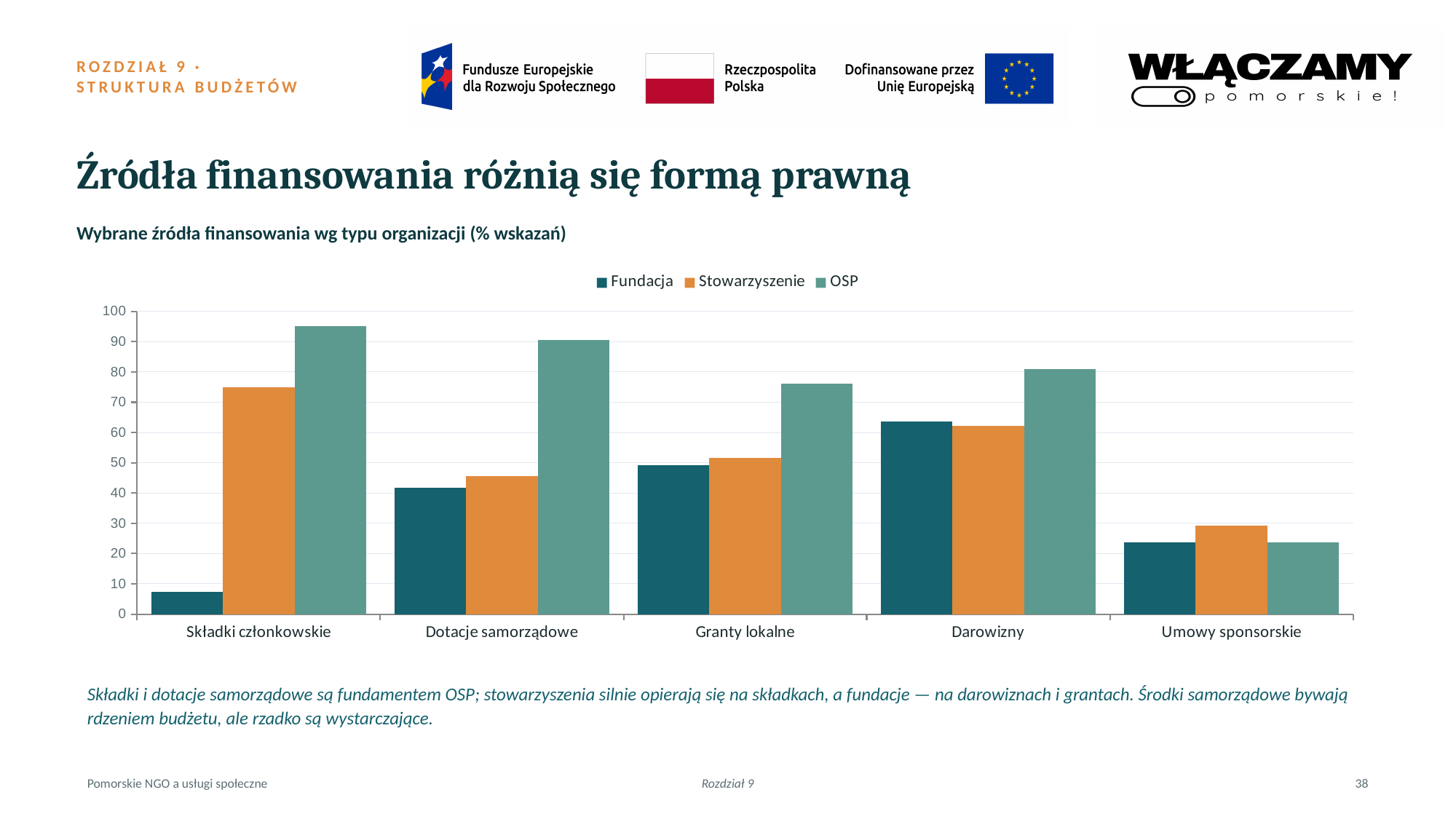
Is the value for OSP in Dotacje samorządowe greater or less than 80? greater Which series has the lowest value for Składki członkowskie? Fundacja Which is larger for Granty lokalne: Fundacja or OSP? OSP How many categories are shown on the x axis? 5 Is the value for OSP in Składki członkowskie greater or less than 90? greater Is the value for Fundacja in Składki członkowskie greater or less than 10? less Which series has the highest value for Składki członkowskie? OSP Which series has the highest value for Umowy sponsorskie? Stowarzyszenie What kind of chart is shown on the slide? bar chart Which category has the highest value for Fundacja? Darowizny How many series does the legend list? 3 What is the title of the chart? Wybrane źródła finansowania wg typu organizacji (% wskazań)